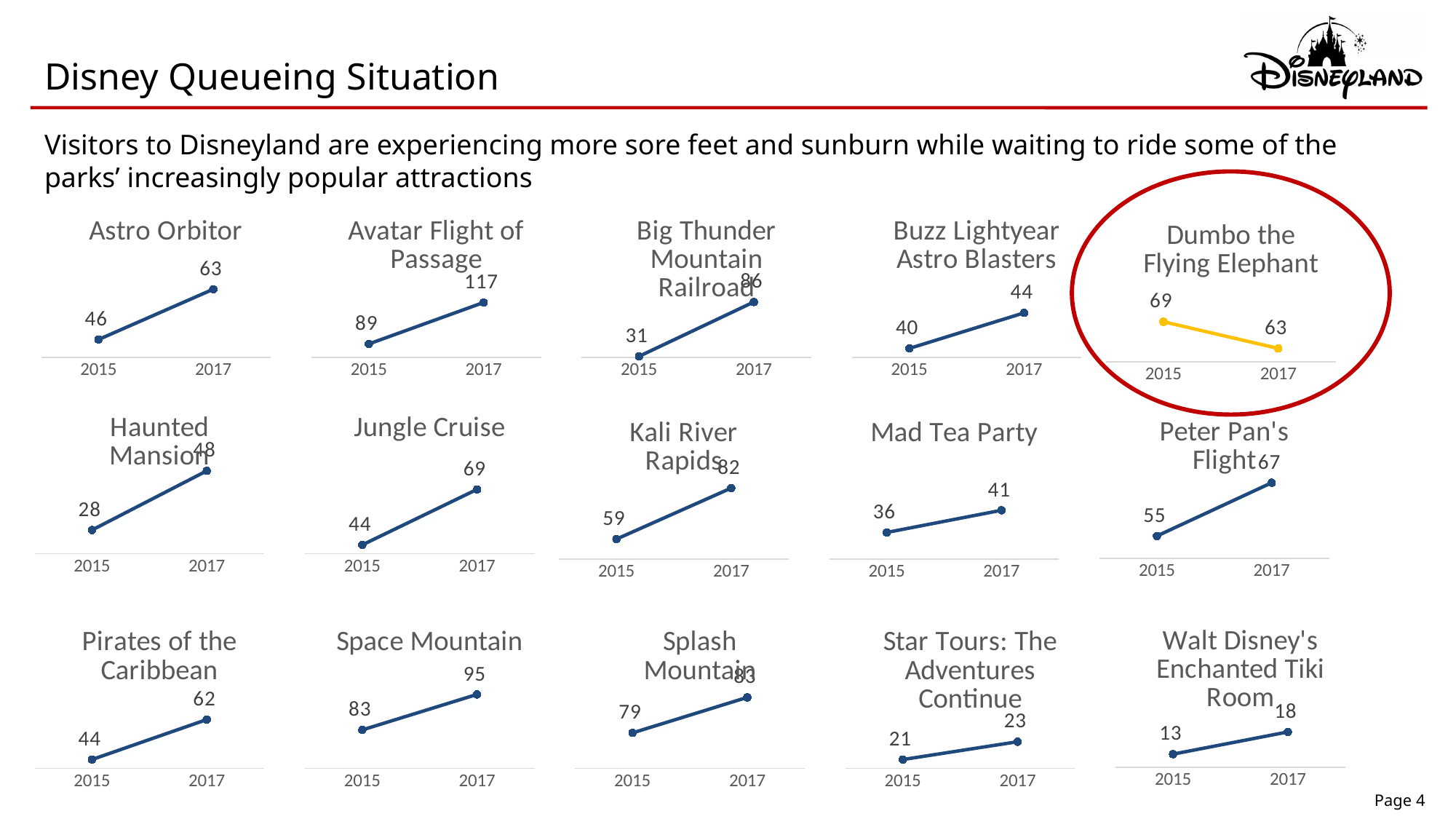
What kind of chart is used for Mad Tea Party? line chart Which chart on the slide is circled in red? Dumbo the Flying Elephant How many data points are plotted in the Star Tours: The Adventures Continue chart? 2 In the Dumbo the Flying Elephant chart, what is the value for 2015? 69 In the Space Mountain chart, which year has the higher value, 2015 or 2017? 2017 In the Dumbo the Flying Elephant chart, do the values rise or fall from 2015 to 2017? fall In the Avatar Flight of Passage chart, what is the value for 2017? 117 In the Jungle Cruise chart, do the values rise or fall from 2015 to 2017? rise In the Walt Disney's Enchanted Tiki Room chart, what is the value for 2015? 13 In the Haunted Mansion chart, what is the difference between the 2017 and 2015 values? 20 In the Big Thunder Mountain Railroad chart, what is the difference between the 2017 and 2015 values? 55 In the Kali River Rapids chart, what is the value for 2017? 82